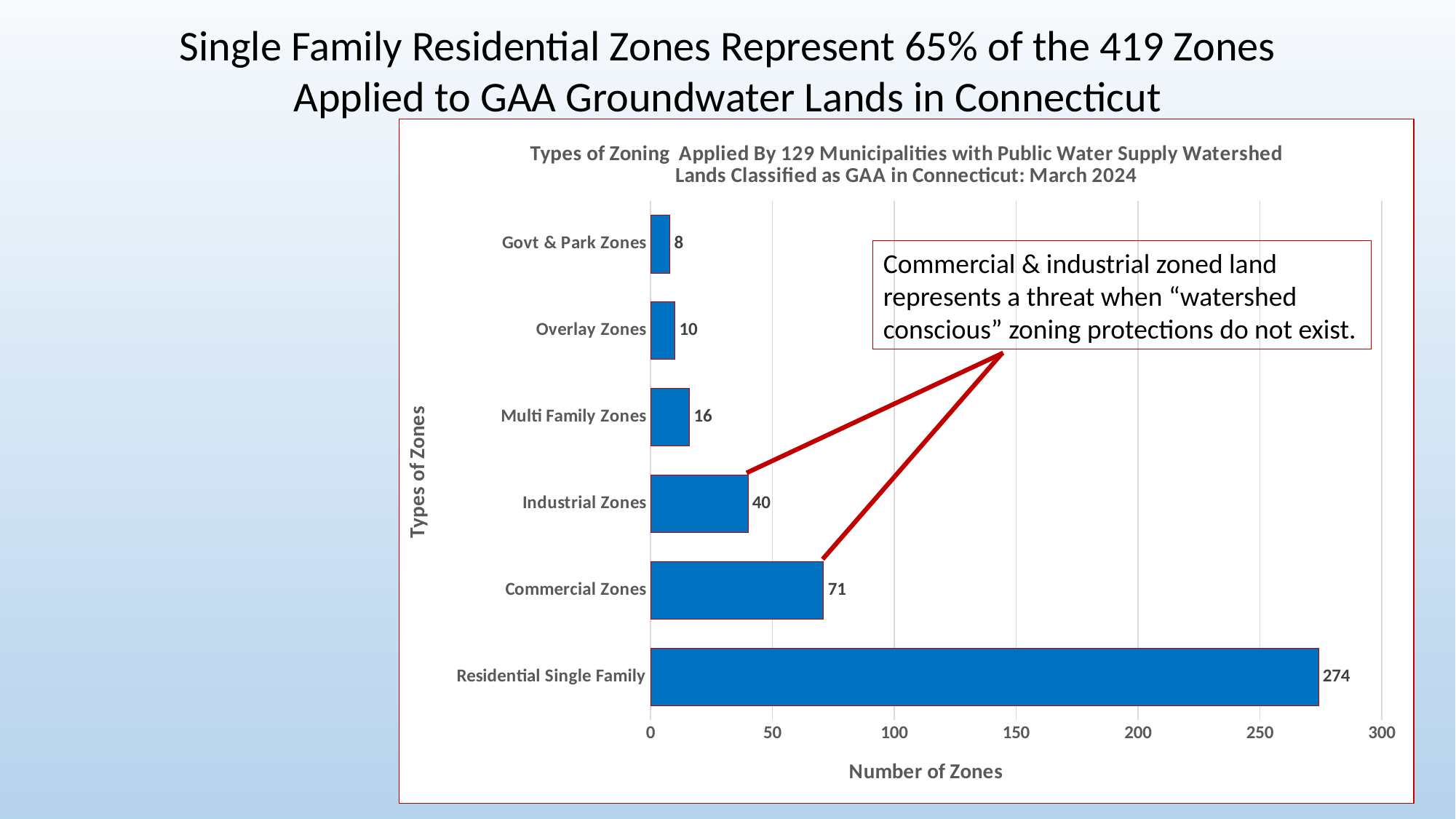
What is the number of zones for Commercial Zones? 71 What is the number of zones for Multi Family Zones? 16 Which type of zone has the lowest number of zones? Govt & Park Zones What is the label of the horizontal axis of the chart? Number of Zones What is the number of zones for Govt & Park Zones? 8 Is the value for Residential Single Family greater or less than 250? greater Which type of zone has the highest number of zones? Residential Single Family What kind of chart is shown on the slide? Bar chart What is the number of zones for Industrial Zones? 40 What is the difference between the number of Commercial Zones and Industrial Zones? 31 How many types of zones are shown in the chart? 6 Which has more zones, Overlay Zones or Multi Family Zones? Multi Family Zones